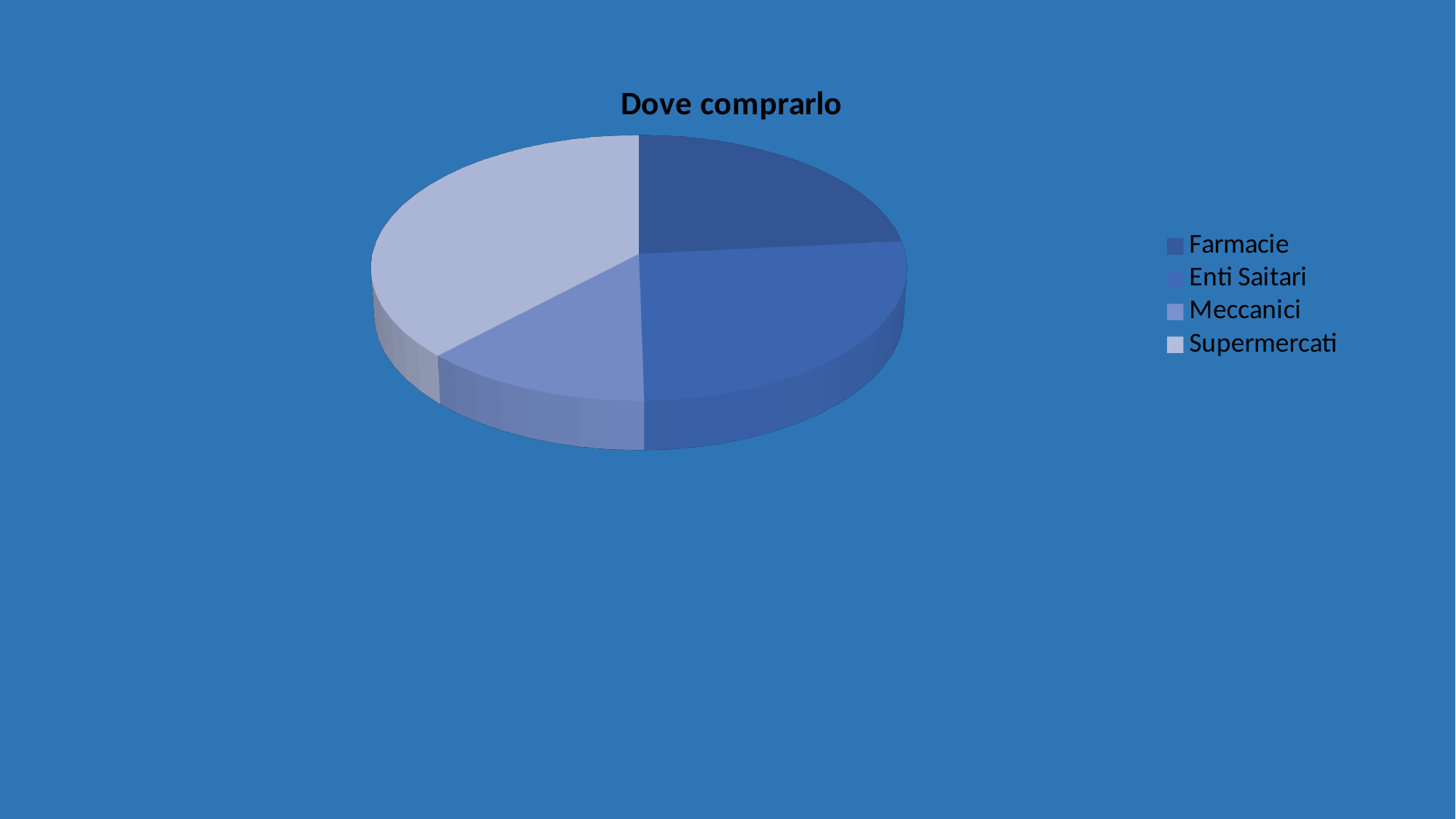
Which category has the smallest slice of the pie? Meccanici Which legend entry is shown with the lightest colour? Supermercati Which slice is larger, Enti Saitari or Meccanici? Enti Saitari What kind of chart is shown on the slide? pie chart Which slice is larger, Supermercati or Farmacie? Supermercati How many entries does the legend list? 4 Which slice is larger, Supermercati or Meccanici? Supermercati Which category has the largest slice of the pie? Supermercati How many slices does the pie chart have? 4 What is the title of the chart? Dove comprarlo